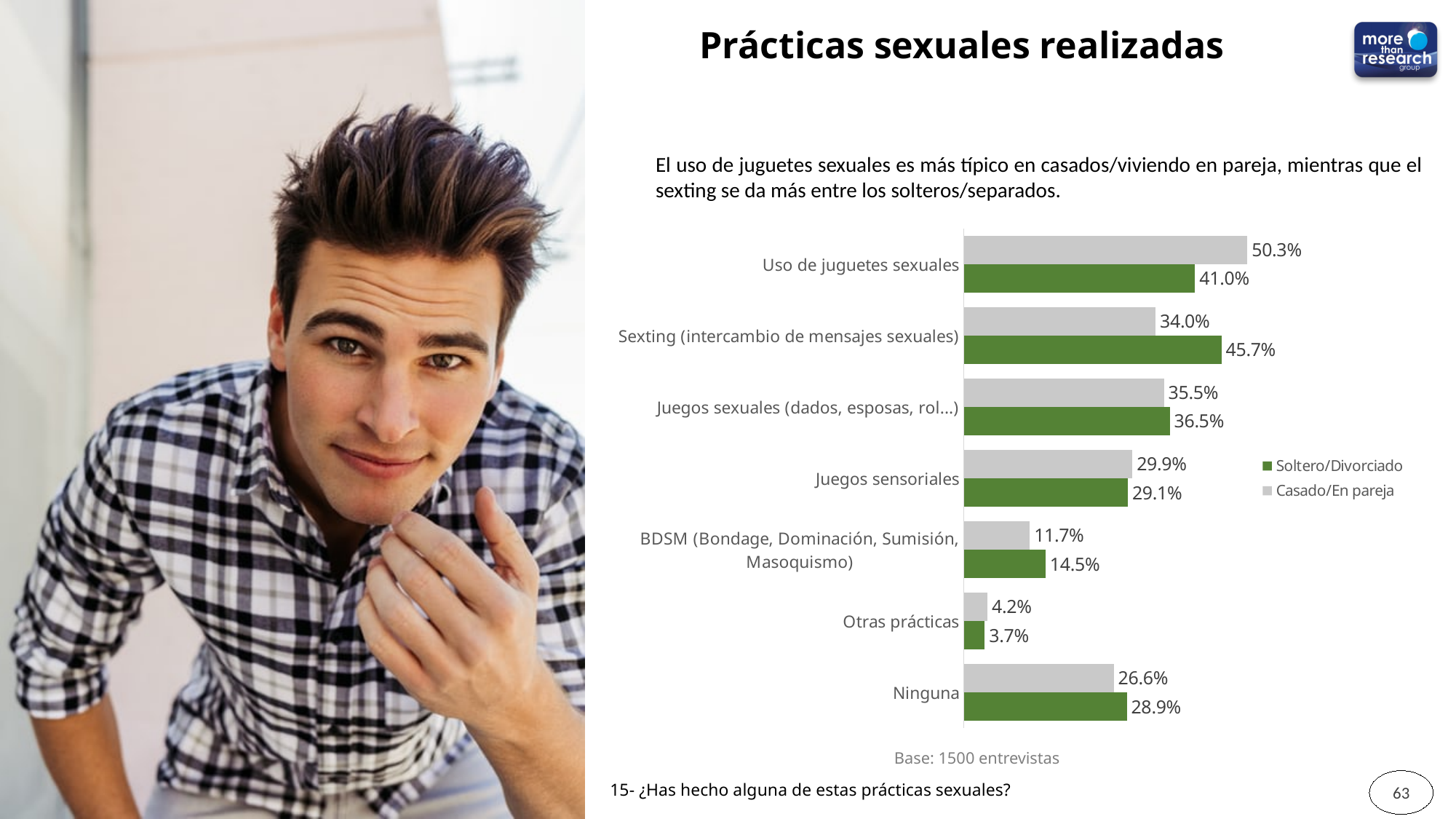
For Sexting (intercambio de mensajes sexuales), which series has the larger value, Soltero/Divorciado or Casado/En pareja? Soltero/Divorciado What is the value for Soltero/Divorciado for Sexting (intercambio de mensajes sexuales)? 45.7% Which category has the highest value for the Casado/En pareja series? Uso de juguetes sexuales What is the value for Casado/En pareja for Ninguna? 26.6% What is the difference between the Soltero/Divorciado and Casado/En pareja values for Sexting (intercambio de mensajes sexuales)? 11.7% What kind of chart is shown on the slide? Bar chart What is the difference between the Casado/En pareja and Soltero/Divorciado values for Uso de juguetes sexuales? 9.3% How many series does the legend list? 2 How many categories are shown in the chart? 7 What is the value for Soltero/Divorciado for BDSM (Bondage, Dominación, Sumisión, Masoquismo)? 14.5% Which category has the lowest value for the Soltero/Divorciado series? Otras prácticas What is the value for Casado/En pareja for Uso de juguetes sexuales? 50.3%